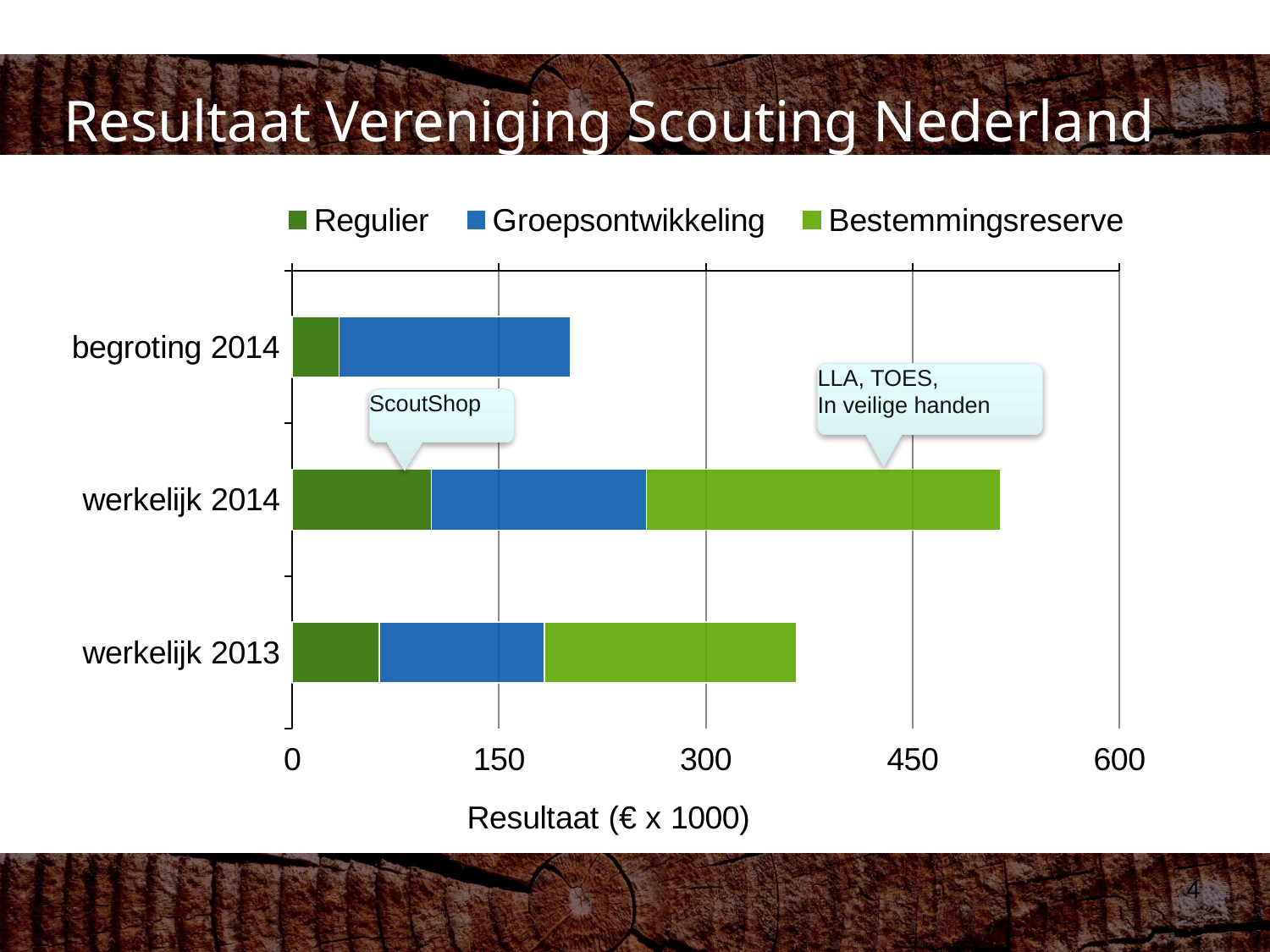
Which category has the longest total bar? werkelijk 2014 Is the total bar for begroting 2014 greater or less than 300? less Which category has no Bestemmingsreserve segment? begroting 2014 Which has the larger total bar, werkelijk 2014 or werkelijk 2013? werkelijk 2014 How many series does the legend list? 3 Is the total bar for werkelijk 2013 greater or less than 300? greater Which series is shown in blue in the legend? Groepsontwikkeling Which category has the shortest total bar? begroting 2014 What kind of chart is shown on the slide? Stacked bar chart Is the total bar for werkelijk 2014 greater or less than 450? greater How many categories are plotted on the chart? 3 What is the title of the x axis? Resultaat (€ x 1000)